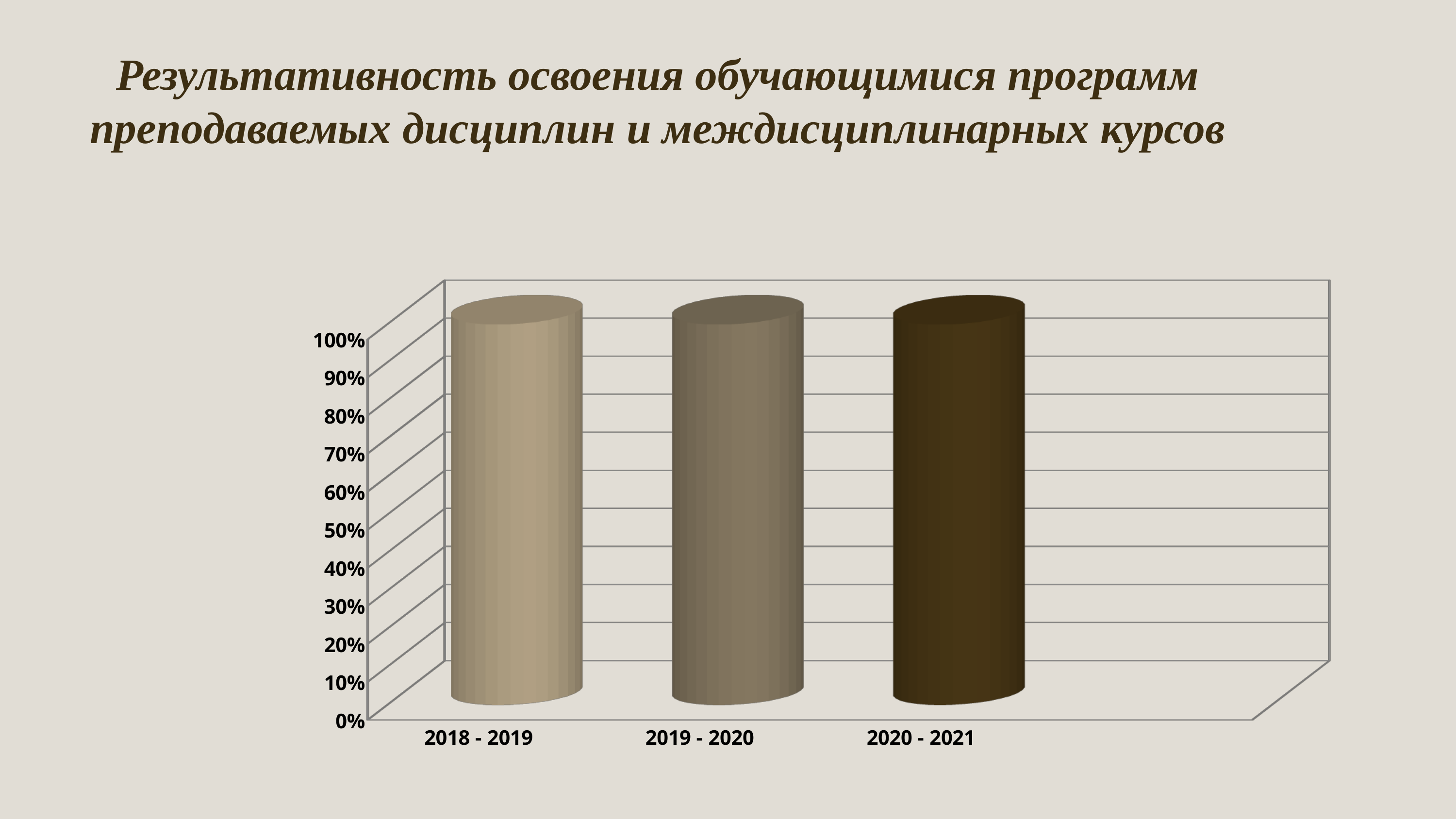
How many categories (academic years) are shown on the x axis of the chart? 3 What kind of chart is shown on the slide? bar chart Is the value for 2018 - 2019 greater or less than 70%? greater Is the value for 2020 - 2021 greater or less than 90%? greater What is the highest tick value shown on the vertical axis of the chart? 100% Is the value for 2019 - 2020 greater or less than 80%? greater What is the first category label on the x axis of the chart? 2018 - 2019